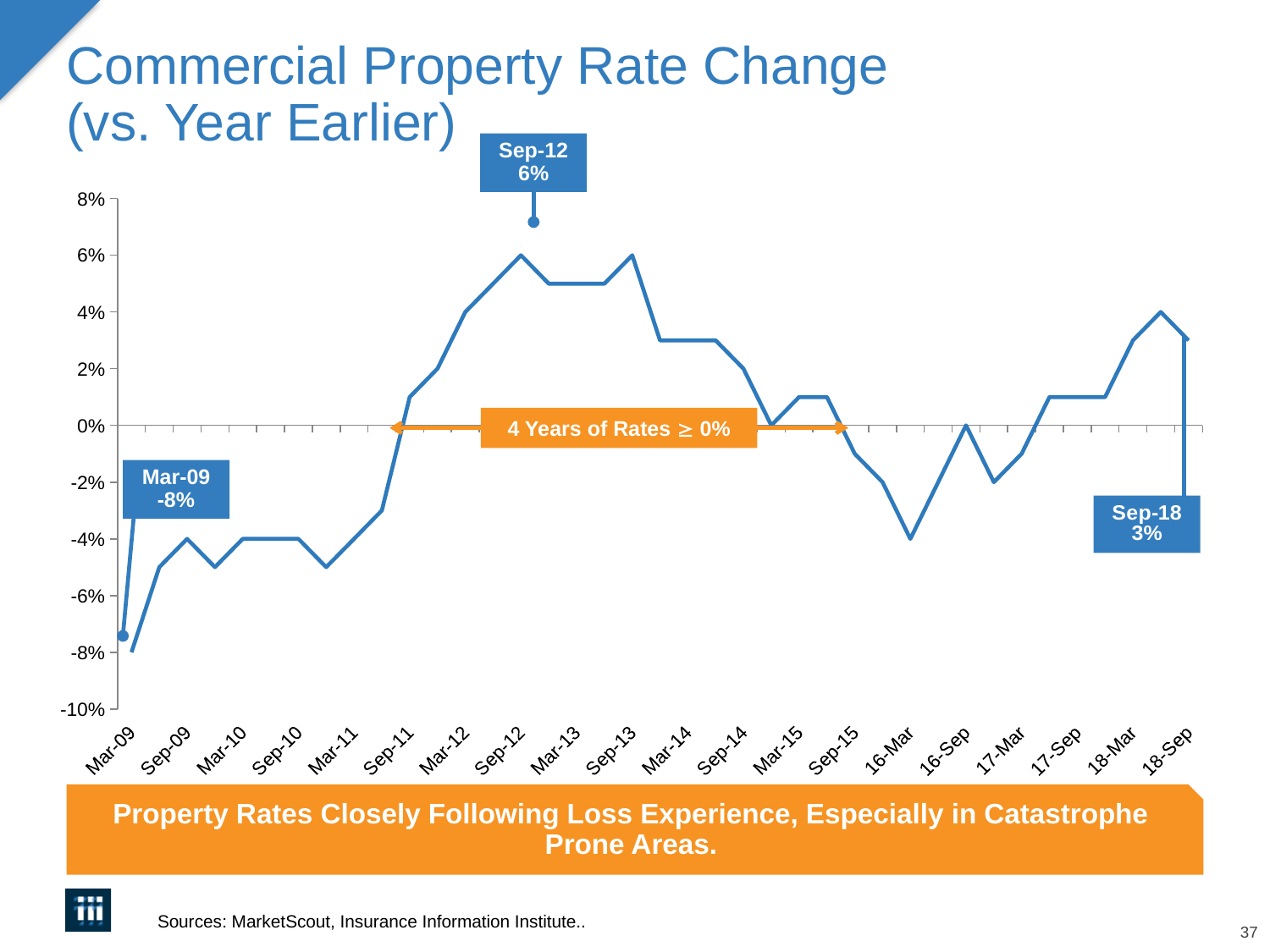
What is the difference between the rate change at Sep-12 and at Mar-09? 14 percentage points What does the orange annotation across the 0% line say? 4 Years of Rates ≥ 0% What is the commercial property rate change shown for Sep-12? 6% What is the title of the chart? Commercial Property Rate Change (vs. Year Earlier) Does the rate change generally rise or fall between Mar-09 and Sep-12? rise Is the rate change at Sep-13 greater or less than 4%? greater What is the commercial property rate change shown for Mar-09? -8% What is the commercial property rate change shown for Sep-18? 3% Is the rate change at Mar-11 greater or less than 0%? less What kind of chart is shown on the slide? line chart Which labelled point has the lowest rate change on the chart? Mar-09 Which is larger, the rate change at Sep-12 or at Sep-18? Sep-12